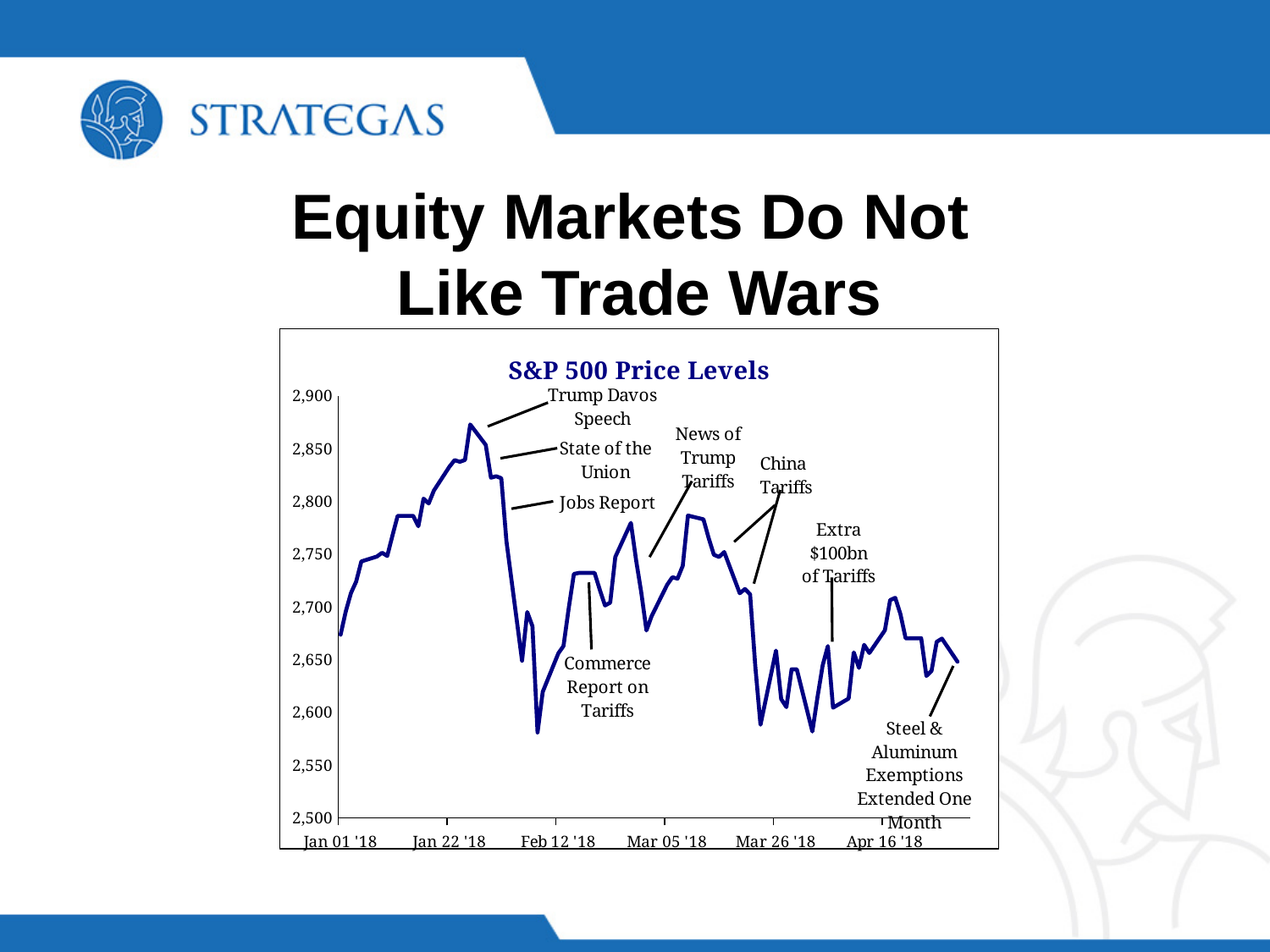
Does the S&P 500 rise or fall from its late-January peak to the end of the chart? fall Is the peak value of the S&P 500 near the Trump Davos Speech annotation greater or less than 2,850? greater Which is higher: the S&P 500 level at Jan 22 '18 or at Mar 26 '18? Jan 22 '18 How many date labels are shown along the x axis? 6 What kind of chart is shown on the slide? line chart Does the S&P 500 rise or fall between Jan 01 '18 and Jan 22 '18? rise Is the lowest point of the S&P 500 in early February 2018 greater or less than 2,600? less How many lines (series) are plotted on the chart? 1 What is the highest value shown on the y axis? 2,900 Is the S&P 500 value at the last point on the chart greater or less than 2,600? greater What is the title of the chart? S&P 500 Price Levels